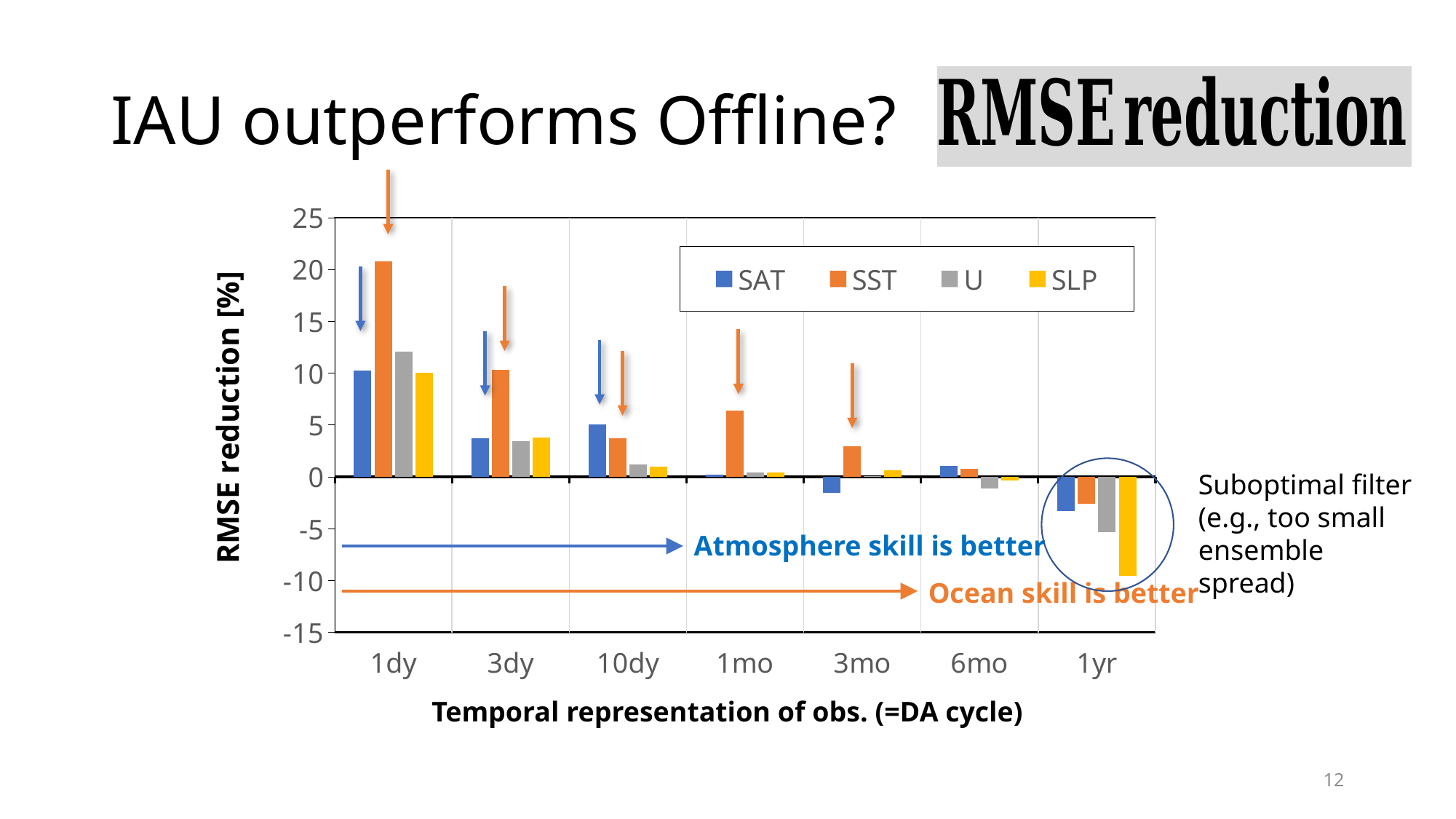
Overall, do the SST values rise or fall from 1dy to 1yr? fall For which category is the SST bar the highest? 1dy What kind of chart is shown on the slide? bar chart Is the U value at 1dy greater or less than 10? greater Which series has the highest RMSE reduction at 1dy? SST At 10dy, which is larger, the SAT value or the SST value? SAT Which series has the lowest value at 1yr? SLP What is the title of the y axis? RMSE reduction [%] Is the SLP value at 1yr greater or less than -5? less How many series does the legend list? 4 How many categories are shown on the x axis? 7 Is the SST value at 1dy greater or less than 15? greater